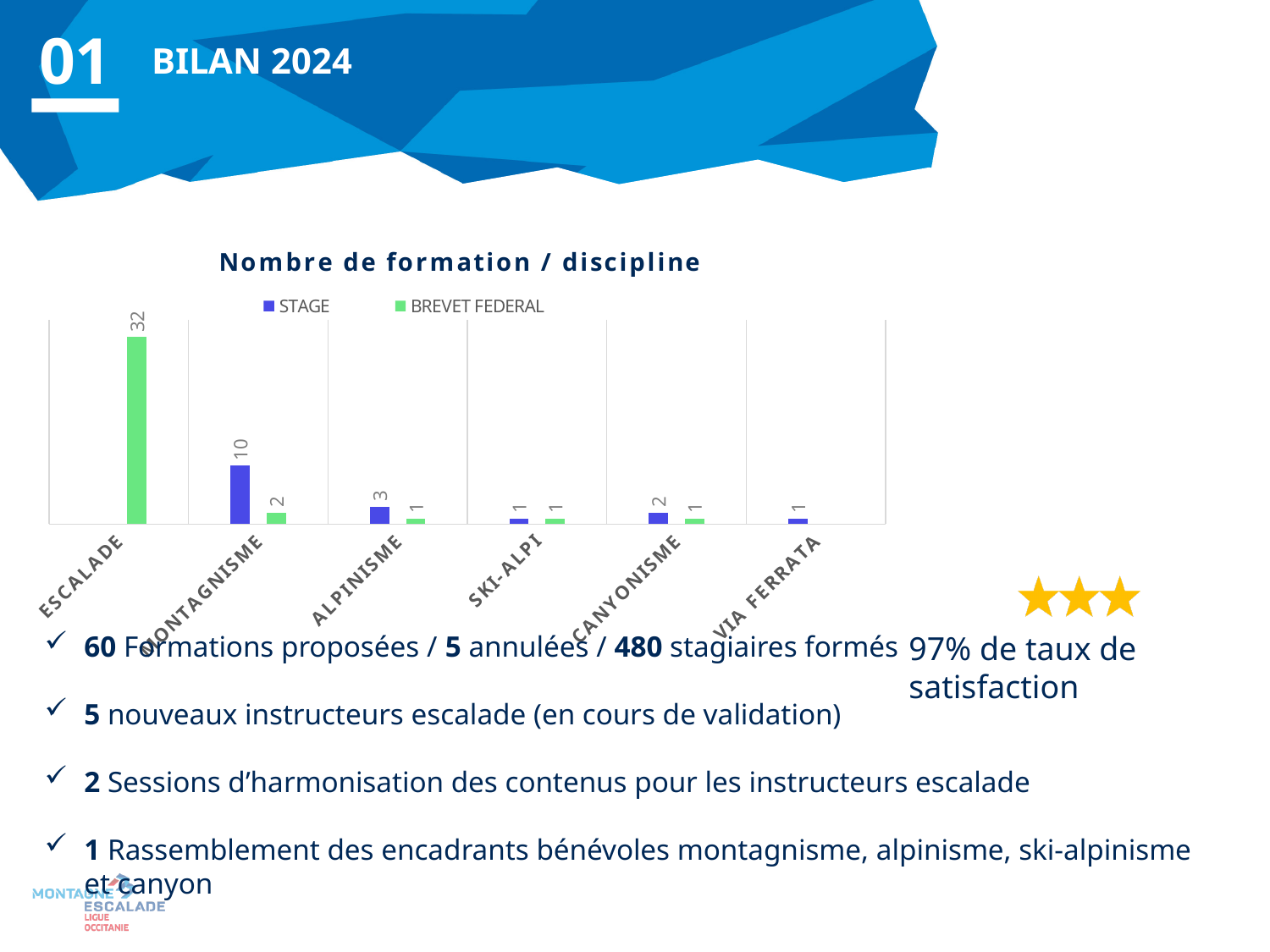
What is the title of the chart? Nombre de formation / discipline Which category has the highest STAGE value? MONTAGNISME What is the STAGE value for ALPINISME? 3 What is the BREVET FEDERAL value for ESCALADE? 32 Which category has the highest BREVET FEDERAL value? ESCALADE What is the BREVET FEDERAL value for MONTAGNISME? 2 What is the STAGE value for CANYONISME? 2 What is the STAGE value for MONTAGNISME? 10 How many categories are shown on the x axis? 6 How many series does the legend list? 2 Which is larger: the STAGE value for ALPINISME or the STAGE value for CANYONISME? STAGE value for ALPINISME What is the difference between the STAGE and BREVET FEDERAL values for MONTAGNISME? 8